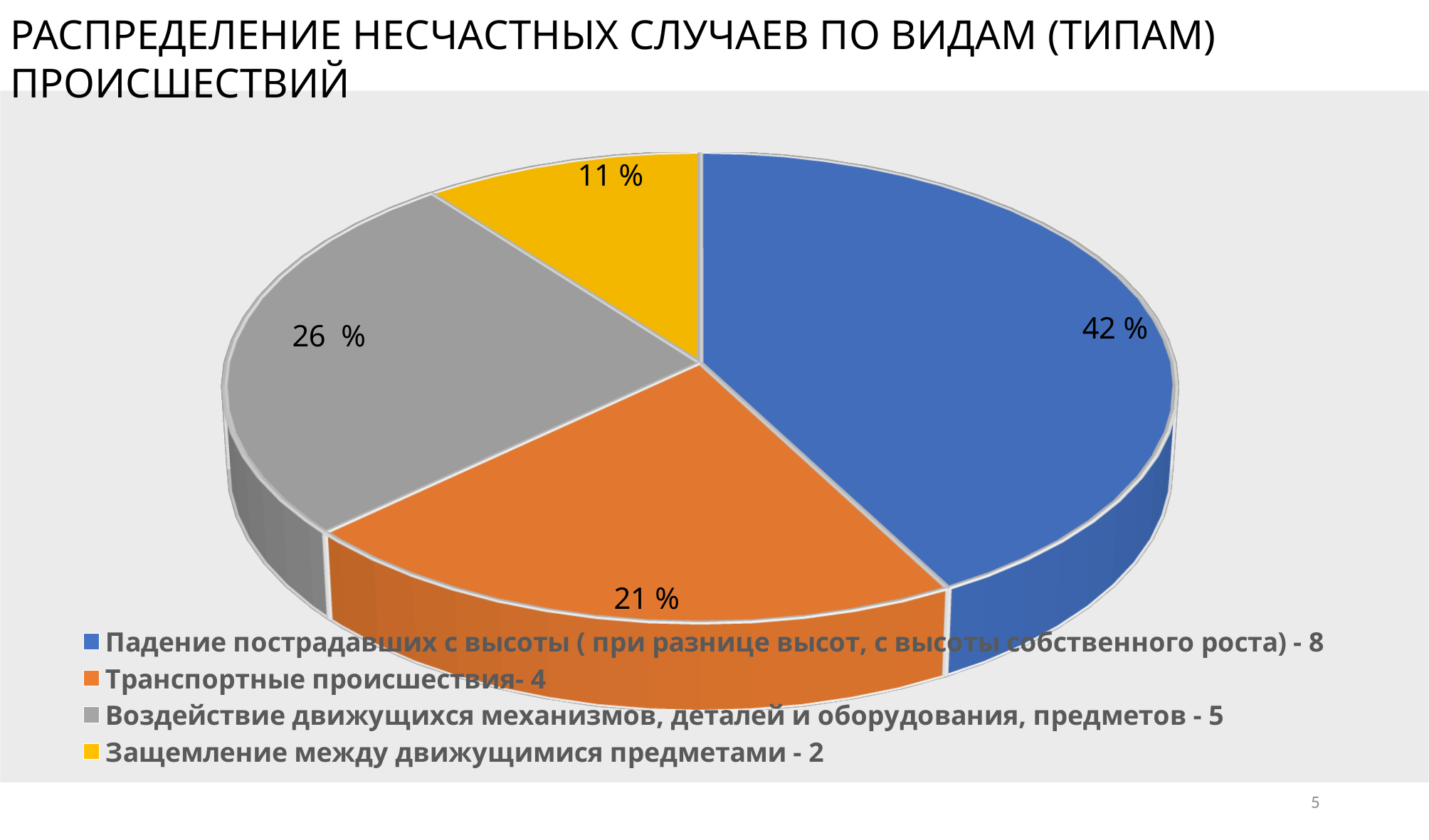
Which category has the largest share of the pie? Падение пострадавших с высоты What kind of chart is shown on the slide? Pie chart What is the difference in percentage points between the shares for "Падение пострадавших с высоты" and "Транспортные происшествия"? 21 % What percentage share is shown for "Падение пострадавших с высоты"? 42 % Which category has the smallest share of the pie? Защемление между движущимися предметами What percentage share is shown for "Защемление между движущимися предметами"? 11 % Which has a larger share: "Воздействие движущихся механизмов" or "Транспортные происшествия"? Воздействие движущихся механизмов How many accidents does the legend list for "Транспортные происшествия"? 4 What colour is the slice for "Защемление между движущимися предметами"? Yellow What percentage share is shown for "Транспортные происшествия"? 21 % How many slices does the pie chart have? 4